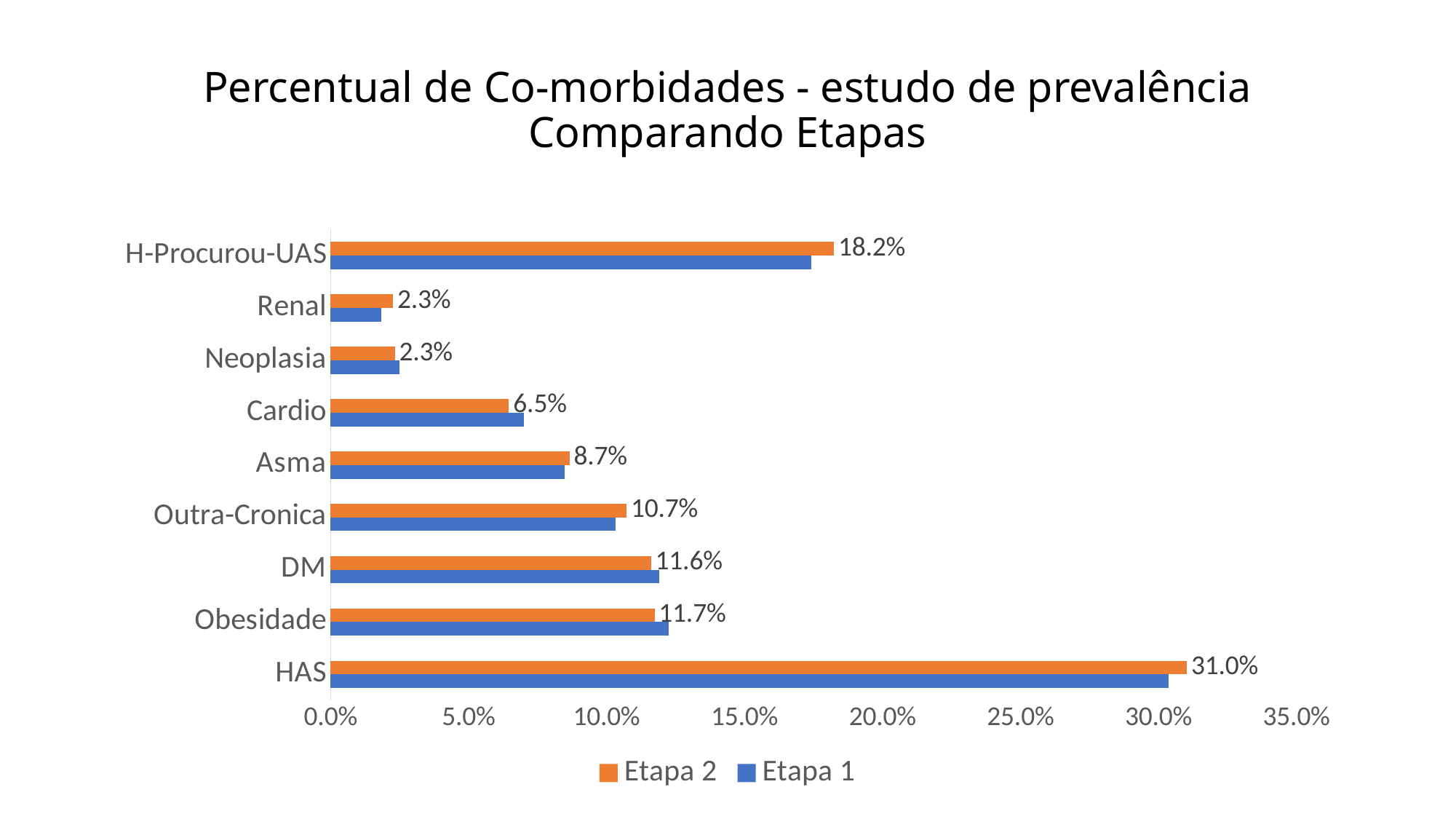
What is the Etapa 2 value for HAS? 31.0% Which category has the highest Etapa 2 value? HAS What is the Etapa 2 value for H-Procurou-UAS? 18.2% What is the Etapa 2 value for Cardio? 6.5% How many categories are shown on the chart? 9 What is the Etapa 2 value for Outra-Cronica? 10.7% Which has a larger Etapa 2 value, Asma or Cardio? Asma How many series does the legend list? 2 Is the Etapa 1 value for H-Procurou-UAS greater or less than 20.0%? less What is the difference between the Etapa 2 values for HAS and Obesidade? 19.3 percentage points Is the Etapa 1 value for Obesidade greater or less than 10.0%? greater What type of chart is shown on the slide? Bar chart